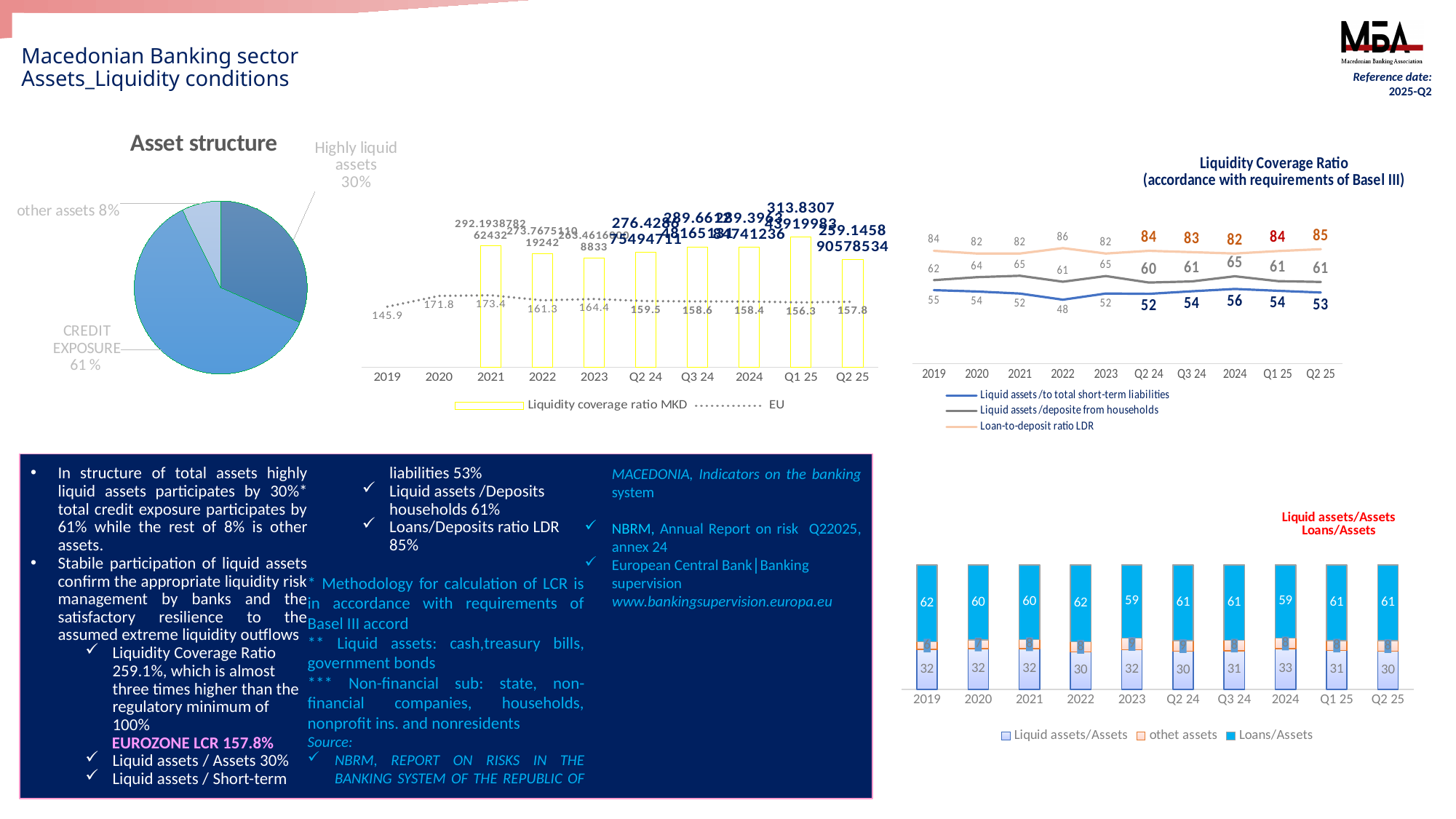
In the Liquidity coverage ratio MKD vs EU chart, in which year or quarter is the EU value highest? 2021 In the Liquidity coverage ratio MKD vs EU chart, what is the EU value for Q2 25? 157.8 In the Asset structure pie chart, what share do highly liquid assets represent? 30% In the Liquidity Coverage Ratio (accordance with requirements of Basel III) chart, what is the Loan-to-deposit ratio LDR for Q2 25? 85 In the Liquidity Coverage Ratio (accordance with requirements of Basel III) chart, what is the lowest value of Liquid assets/to total short-term liabilities and in which year? 48 in 2022 In the Asset structure pie chart, what share is other assets? 8% In the Liquid assets/Assets Loans/Assets stacked bar chart, what is the difference between Loans/Assets and Liquid assets/Assets in Q2 25? 31 In the Liquid assets/Assets Loans/Assets stacked bar chart, what is the Loans/Assets value for 2023? 59 In the Liquidity coverage ratio MKD vs EU chart, how many categories are shown on the x axis? 10 In the Asset structure pie chart, which slice is the largest? CREDIT EXPOSURE In the Liquidity coverage ratio MKD vs EU chart, what is the EU value for 2019? 145.9 In the Liquidity Coverage Ratio (accordance with requirements of Basel III) chart, how many series does the legend list? 3